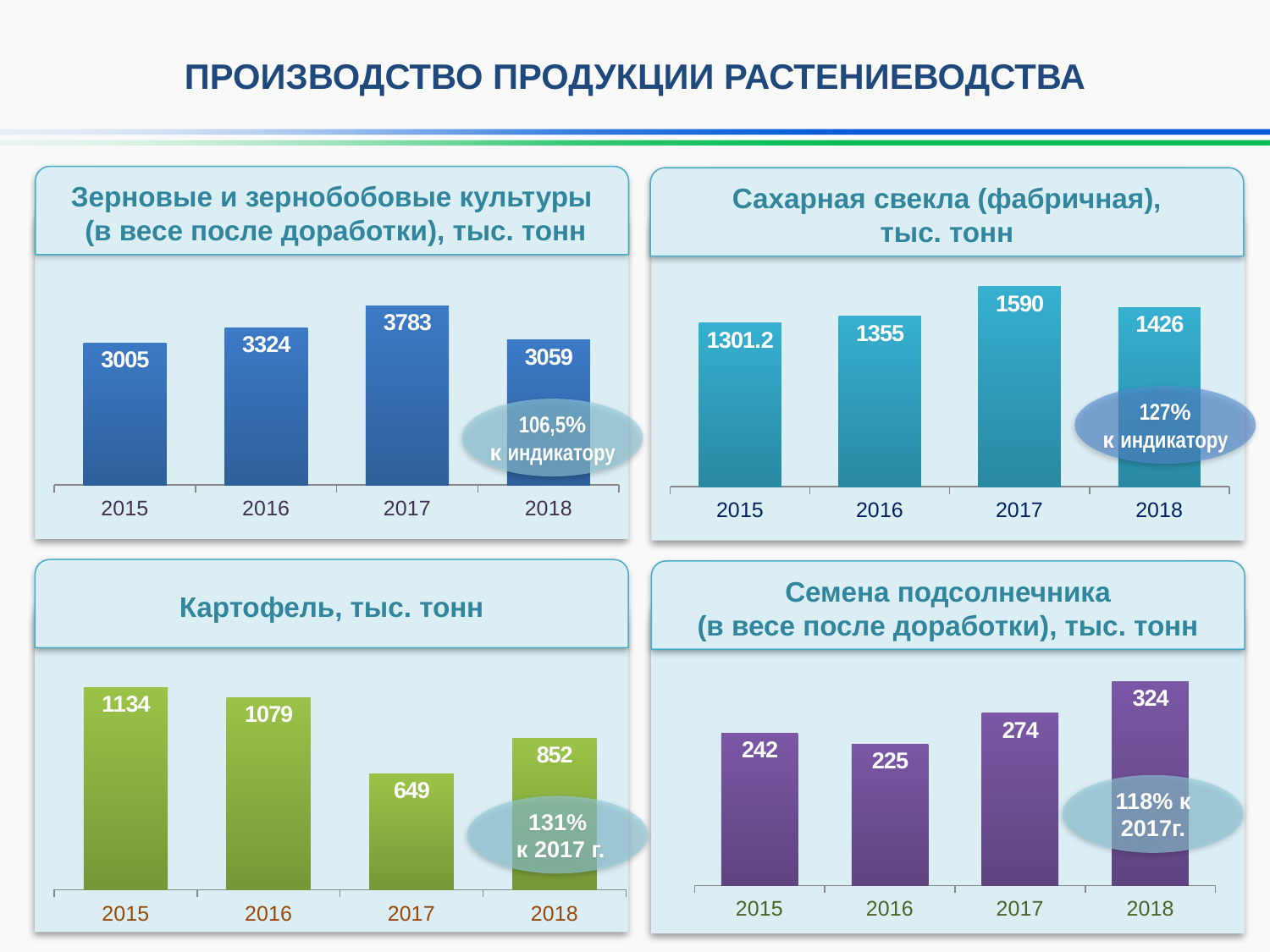
In the chart 'Сахарная свекла (фабричная), тыс. тонн', what is the value for 2015? 1301.2 In the chart 'Зерновые и зернобобовые культуры (в весе после доработки), тыс. тонн', which year has the lowest value? 2015 What kind of chart is 'Семена подсолнечника (в весе после доработки), тыс. тонн'? bar chart In the chart 'Семена подсолнечника (в весе после доработки), тыс. тонн', which is larger, the value for 2015 or 2016? 2015 In the chart 'Картофель, тыс. тонн', which year has the lowest value? 2017 In the chart 'Семена подсолнечника (в весе после доработки), тыс. тонн', what is the value for 2018? 324 How many years are shown on the x axis of the chart 'Картофель, тыс. тонн'? 4 In the chart 'Сахарная свекла (фабричная), тыс. тонн', which year has the highest value? 2017 In the chart 'Сахарная свекла (фабричная), тыс. тонн', what is the difference between the 2017 and 2018 values? 164 In the chart 'Зерновые и зернобобовые культуры (в весе после доработки), тыс. тонн', what is the value for 2017? 3783 In the chart 'Картофель, тыс. тонн', what is the difference between the 2015 and 2016 values? 55 In the chart 'Картофель, тыс. тонн', what is the value for 2018? 852